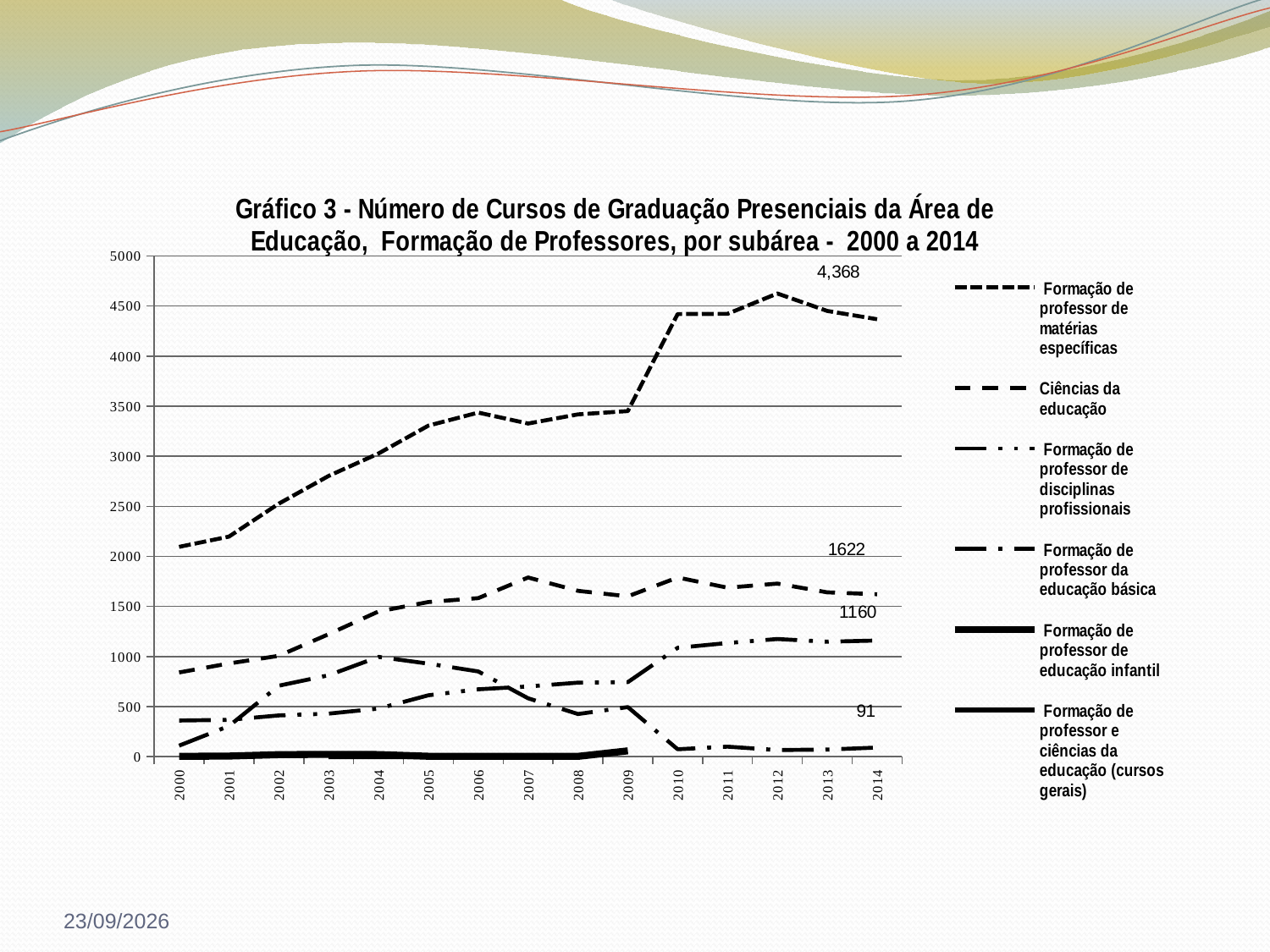
What years does the chart title say the data covers? 2000 a 2014 What is the difference between 'Formação de professor de matérias específicas' and 'Ciências da educação' in 2014? 2746 What kind of chart is shown on the slide? line chart Is the value for 'Formação de professor de matérias específicas' in 2000 greater or less than 2500? less In 2014, which is larger: 'Formação de professor de matérias específicas' or 'Ciências da educação'? Formação de professor de matérias específicas What is the value for 'Ciências da educação' in 2014? 1622 How many years are shown along the x axis? 15 What is the value for 'Formação de professor de matérias específicas' in 2014? 4,368 Is the value for 'Formação de professor de matérias específicas' in 2010 greater or less than 4000? greater How many series does the legend list? 6 Does the 'Formação de professor de matérias específicas' series rise or fall from 2000 to 2012? rise Which series has the highest value in 2014? Formação de professor de matérias específicas